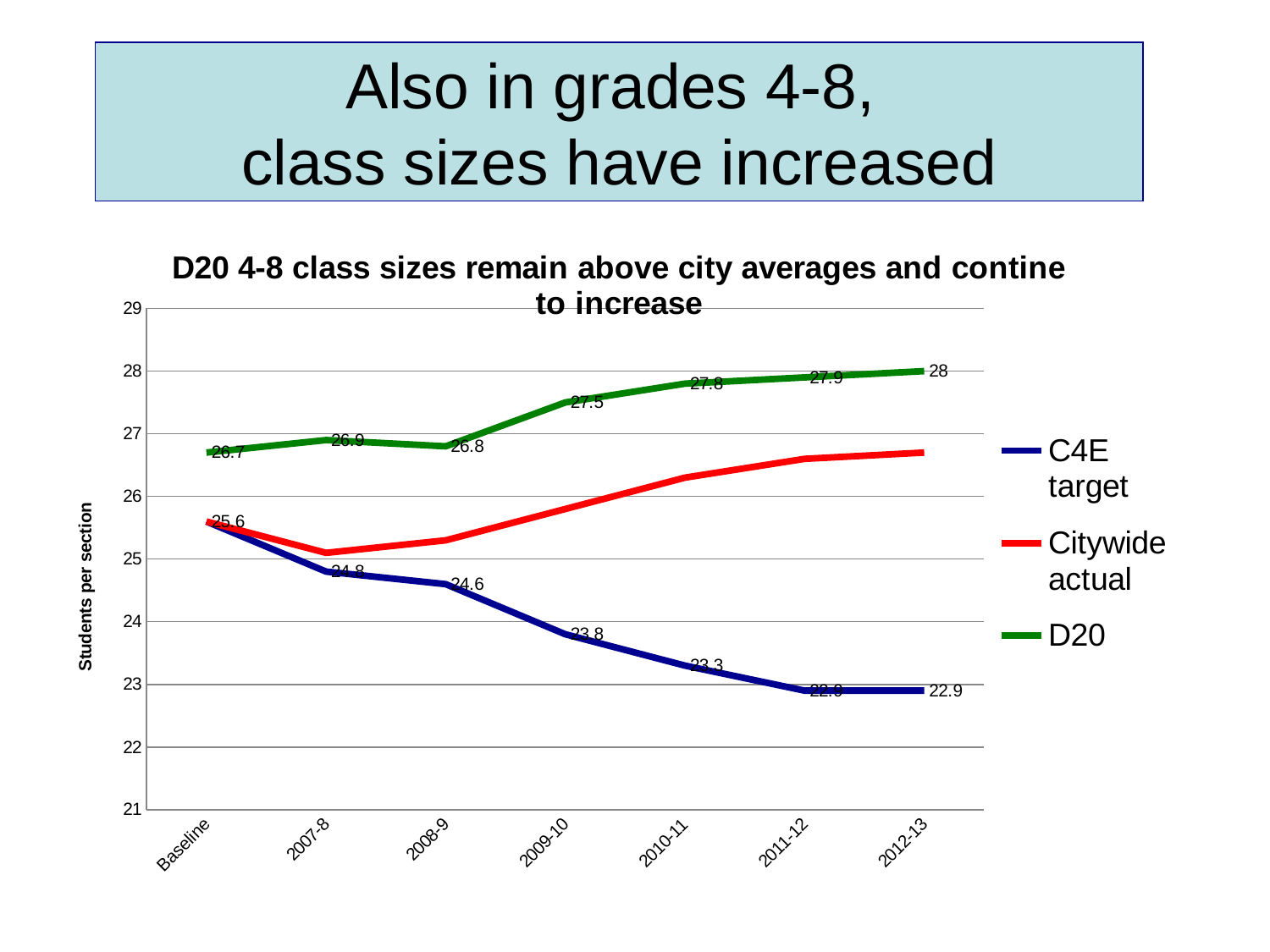
In which year is the D20 value highest? 2012-13 Is the Citywide actual value for 2012-13 greater or less than 26? greater By how much did the D20 value increase from Baseline to 2012-13? 1.3 What kind of chart is shown on the slide? Line chart In 2010-11, which is larger: the D20 value or the C4E target value? D20 What is the C4E target value at Baseline? 25.6 What is the D20 value for 2009-10? 27.5 How many series does the legend list? 3 At which x-axis point is the D20 value lowest? Baseline Does the C4E target series rise or fall from Baseline to 2012-13? Fall What is the D20 value for 2012-13? 28 How many points are plotted along the x axis for each series? 7